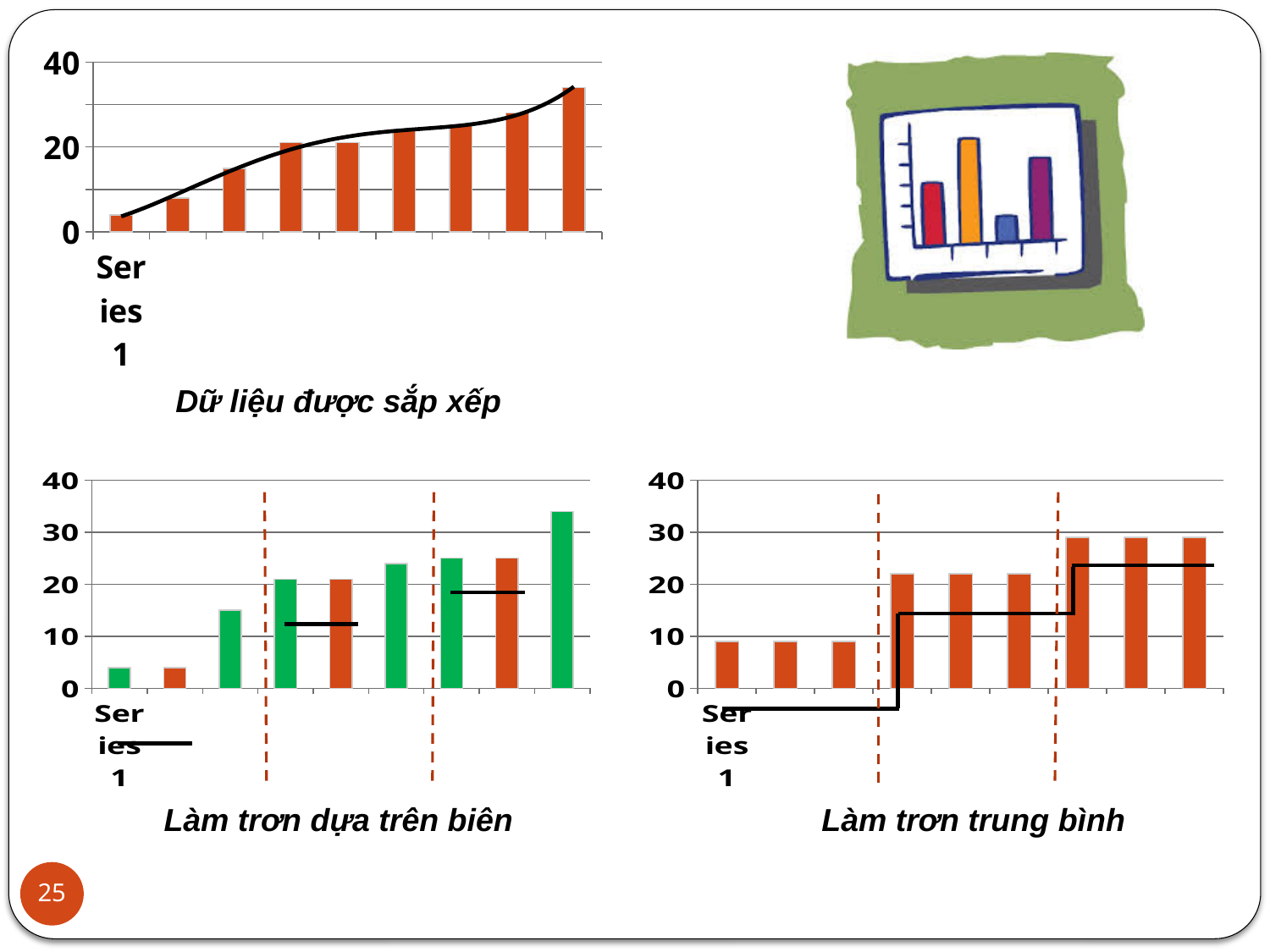
In the top-left chart "Dữ liệu được sắp xếp", which bar is the tallest? the rightmost (last) bar What is the title shown under the bottom-right chart? Làm trơn trung bình In the bottom-right chart "Làm trơn trung bình", is the value of the rightmost bar greater or less than 20? greater What kind of chart is the top-left chart titled "Dữ liệu được sắp xếp"? bar chart In the top-left chart "Dữ liệu được sắp xếp", do the bar values rise or fall from left to right? rise In the top-left chart "Dữ liệu được sắp xếp", how many bars are plotted? 9 In the bottom-right chart "Làm trơn trung bình", which group of three bars is the tallest? the rightmost group In the top-left chart "Dữ liệu được sắp xếp", is the value of the last bar greater or less than 20? greater In the bottom-left chart "Làm trơn dựa trên biên", is the value of the rightmost bar greater or less than 30? greater In the top-left chart "Dữ liệu được sắp xếp", which bar is the shortest? the leftmost (first) bar In the bottom-left chart "Làm trơn dựa trên biên", how many bars are plotted? 9